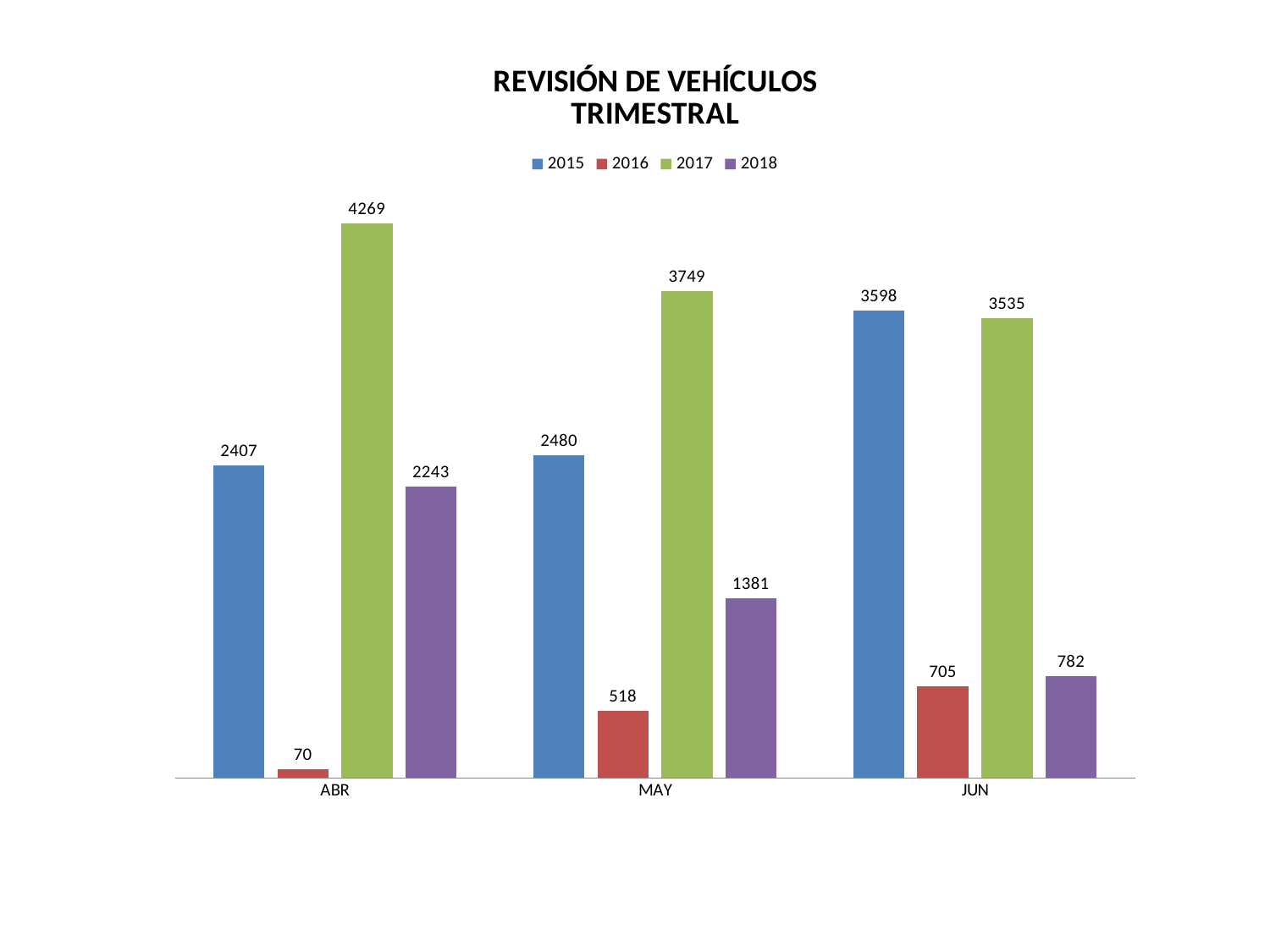
What is the title of the chart? REVISIÓN DE VEHÍCULOS TRIMESTRAL Do the values for 2016 rise or fall from ABR to JUN? rise What is the difference between the 2017 and 2015 values in MAY? 1269 How many months are shown on the x axis? 3 Which month has the highest value for 2015? JUN What is the value for 2018 in JUN? 782 Which month has the lowest value for 2016? ABR What is the value for 2017 in ABR? 4269 What kind of chart is shown? bar chart How many series does the legend list? 4 What is the value for 2016 in MAY? 518 Which is larger in JUN, the value for 2015 or the value for 2017? 2015